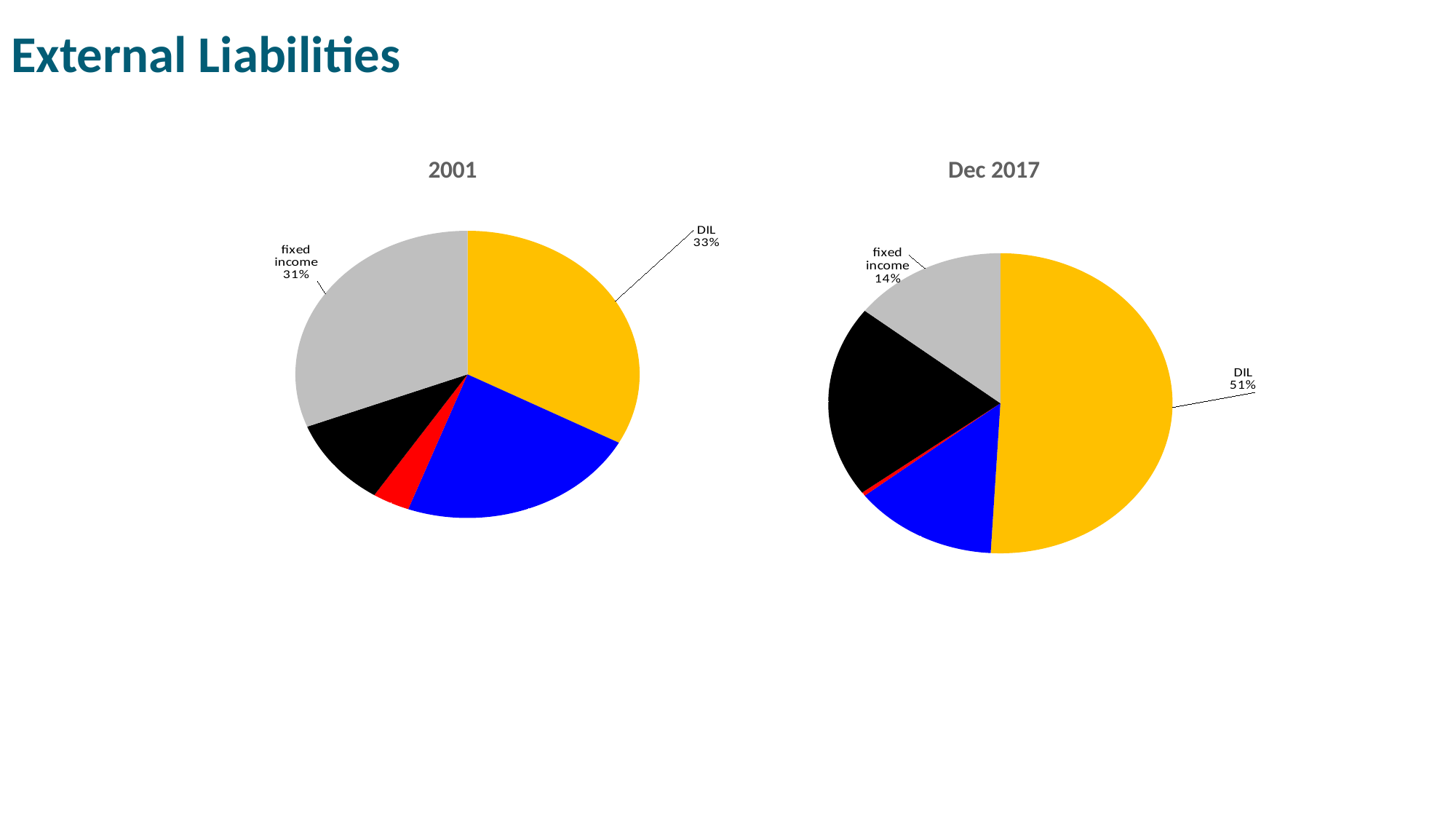
In the 2001 pie chart, what share is labelled for DIL? 33% In the 2001 pie chart, which labelled slice is larger, DIL or fixed income? DIL In the Dec 2017 pie chart, what is the difference in percentage points between the DIL share and the fixed income share? 37 percentage points In the Dec 2017 pie chart, what share is labelled for DIL? 51% In the 2001 pie chart, what is the difference in percentage points between the DIL share and the fixed income share? 2 percentage points In the 2001 pie chart, what share is labelled for fixed income? 31% How many slices does the Dec 2017 pie chart have? 5 What type of chart is used for the 2001 and Dec 2017 data? Pie chart In the Dec 2017 pie chart, which labelled slice is larger, DIL or fixed income? DIL In the Dec 2017 pie chart, which slice is the largest? DIL In the Dec 2017 pie chart, what share is labelled for fixed income? 14% What is the title of the slide containing the two pie charts? External Liabilities